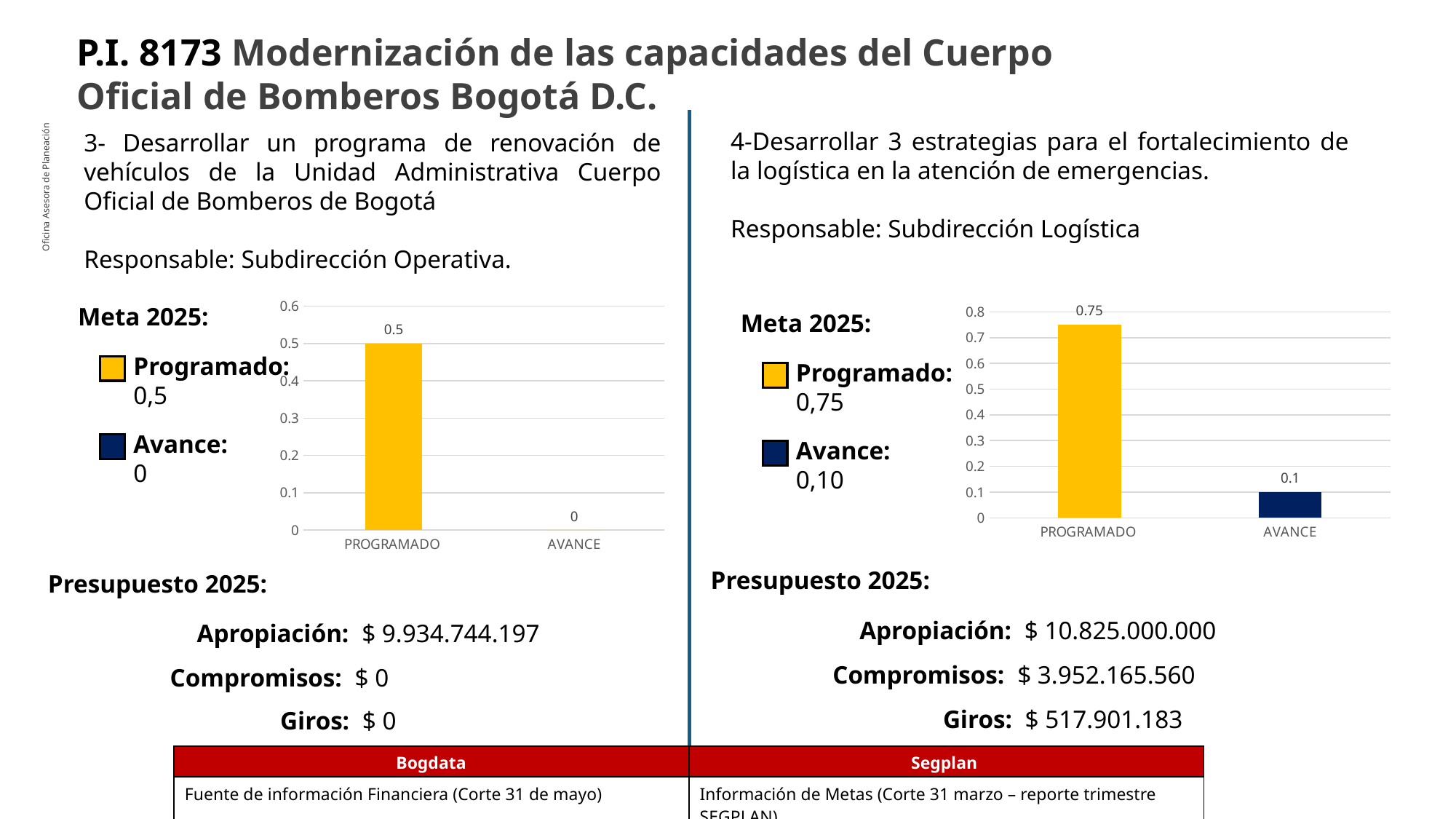
In the right chart, what is the value for PROGRAMADO? 0.75 In the right chart, what is the value for AVANCE? 0.1 In the right chart, which is larger, PROGRAMADO or AVANCE? PROGRAMADO What kind of chart is the right chart? bar chart How many categories are shown on the x axis of the left chart? 2 In the left chart, which category has the lowest value? AVANCE In the left chart, what is the difference between PROGRAMADO and AVANCE? 0.5 In the left chart, what is the value for AVANCE? 0 In the left chart, what is the value for PROGRAMADO? 0.5 In the right chart, what colour is the PROGRAMADO bar? yellow In the right chart, what is the difference between PROGRAMADO and AVANCE? 0.65 In the right chart, which category has the highest value? PROGRAMADO